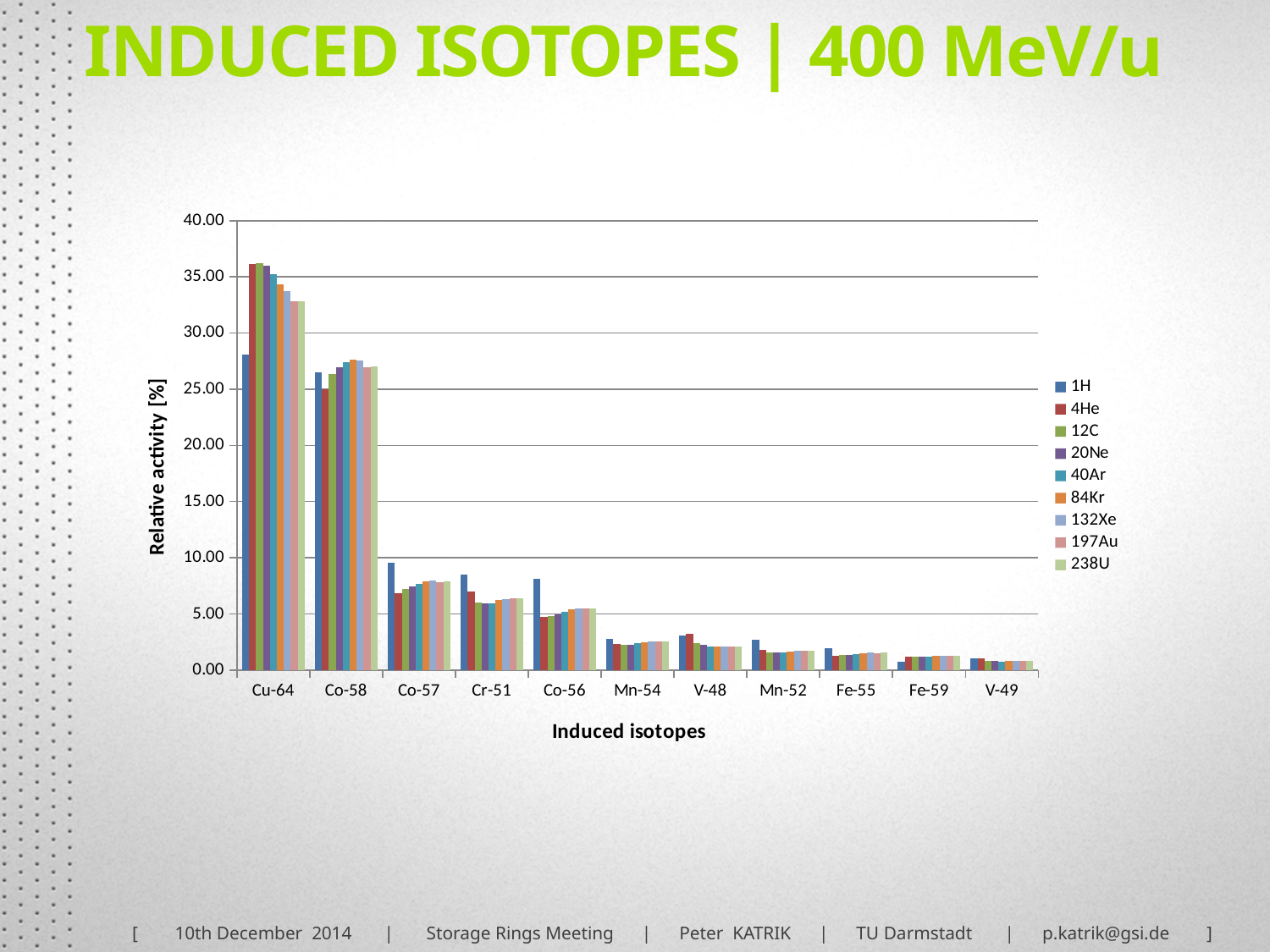
How many induced isotopes (categories) are shown on the x axis? 11 How many series does the legend list? 9 Is the 1H value for Co-57 greater or less than 10.00? less Which induced isotope has the highest relative activity? Cu-64 Is the 1H value for Cr-51 greater or less than 5.00? greater Is the 4He value for Cu-64 greater or less than 30.00? greater Do the relative activity values generally rise or fall from left to right along the x axis? fall For Cu-64, which series has the lowest relative activity? 1H What kind of chart is shown on the slide? bar chart For Co-57, which series has the highest relative activity? 1H Which is larger for the 238U series: the value for Co-58 or the value for Co-57? Co-58